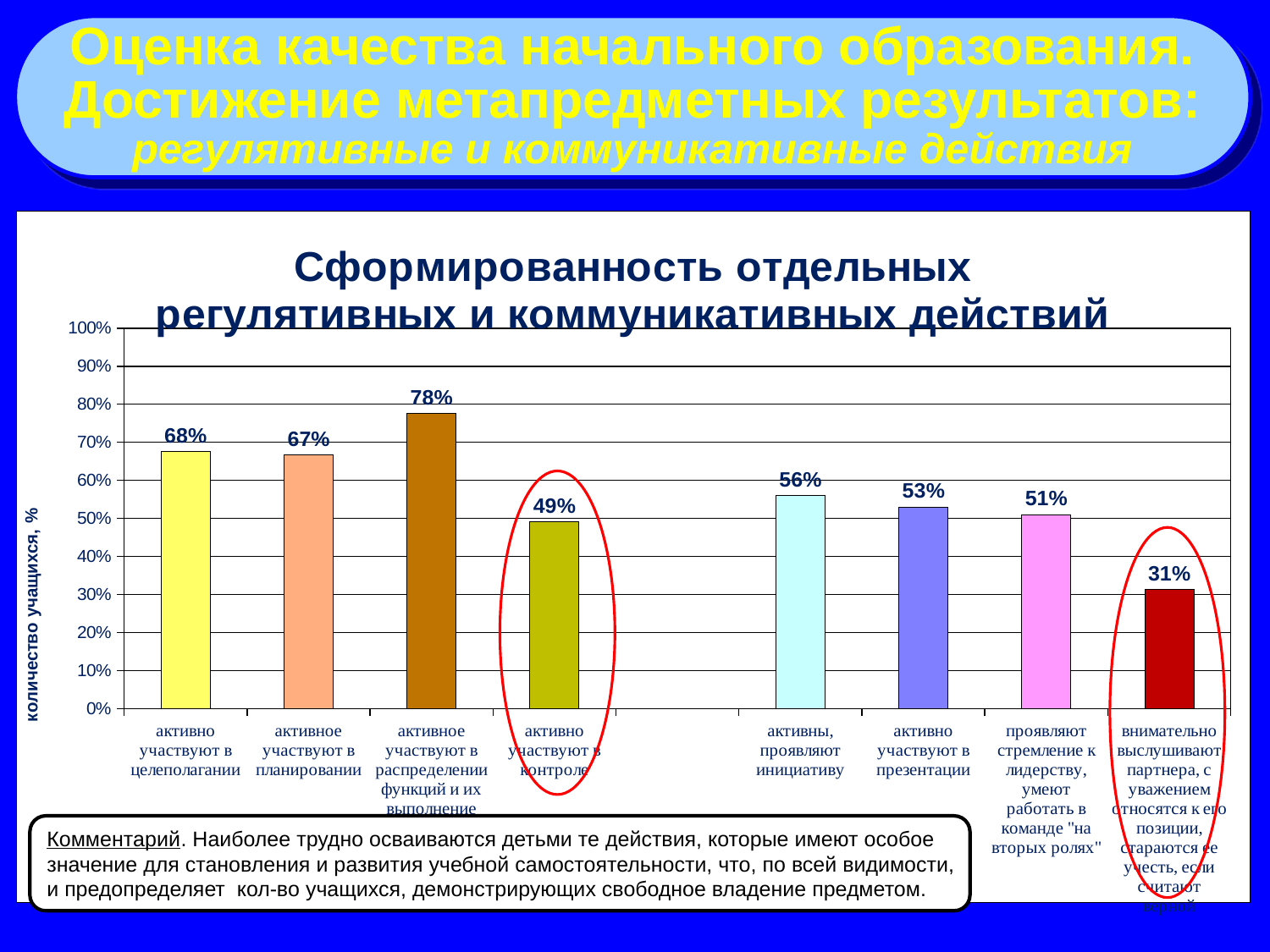
Which category has the lowest value? внимательно выслушивают партнера, с уважением относятся к его позиции, стараются ее учесть, если считают верной What is the value for "активно участвуют в целеполагании"? 68% Is the value for "проявляют стремление к лидерству, умеют работать в команде" greater or less than 60%? less What is the value for "активно участвуют в контроле"? 49% What is the label of the vertical axis? количество учащихся, % What is the title of the chart? Сформированность отдельных регулятивных и коммуникативных действий How many bars are plotted in the chart? 8 What is the difference between the values for "активное участвуют в распределении функций и их выполнение" and "активно участвуют в контроле"? 29% Which is larger: the value for "активны, проявляют инициативу" or the value for "активно участвуют в презентации"? активны, проявляют инициативу What is the value for "активно участвуют в презентации"? 53% Which category has the highest value? активное участвуют в распределении функций и их выполнение What kind of chart is shown on the slide? bar chart